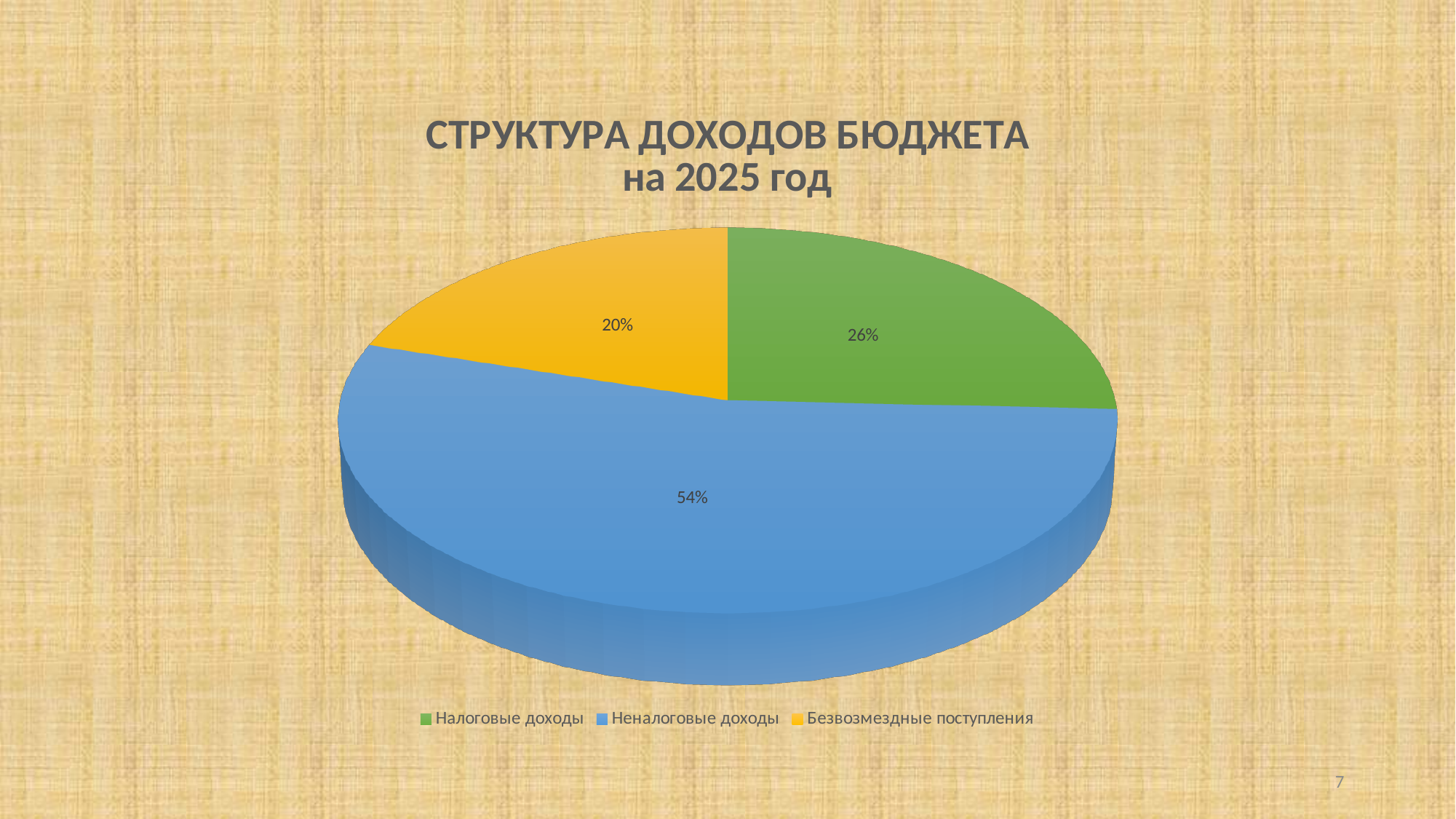
What is the title of the chart? СТРУКТУРА ДОХОДОВ БЮДЖЕТА на 2025 год What share of the pie does Безвозмездные поступления have? 20% Which is larger, the share for Налоговые доходы or the share for Безвозмездные поступления? Налоговые доходы What is the difference in percentage points between Налоговые доходы and Безвозмездные поступления? 6 What is the difference in percentage points between Неналоговые доходы and Налоговые доходы? 28 How many categories are shown in the pie chart? 3 What colour is the slice for Безвозмездные поступления? Yellow Which category has the largest slice of the pie? Неналоговые доходы What share of the pie does Неналоговые доходы have? 54% What share of the pie does Налоговые доходы have? 26% Which category has the smallest slice of the pie? Безвозмездные поступления What kind of chart is shown on the slide? Pie chart